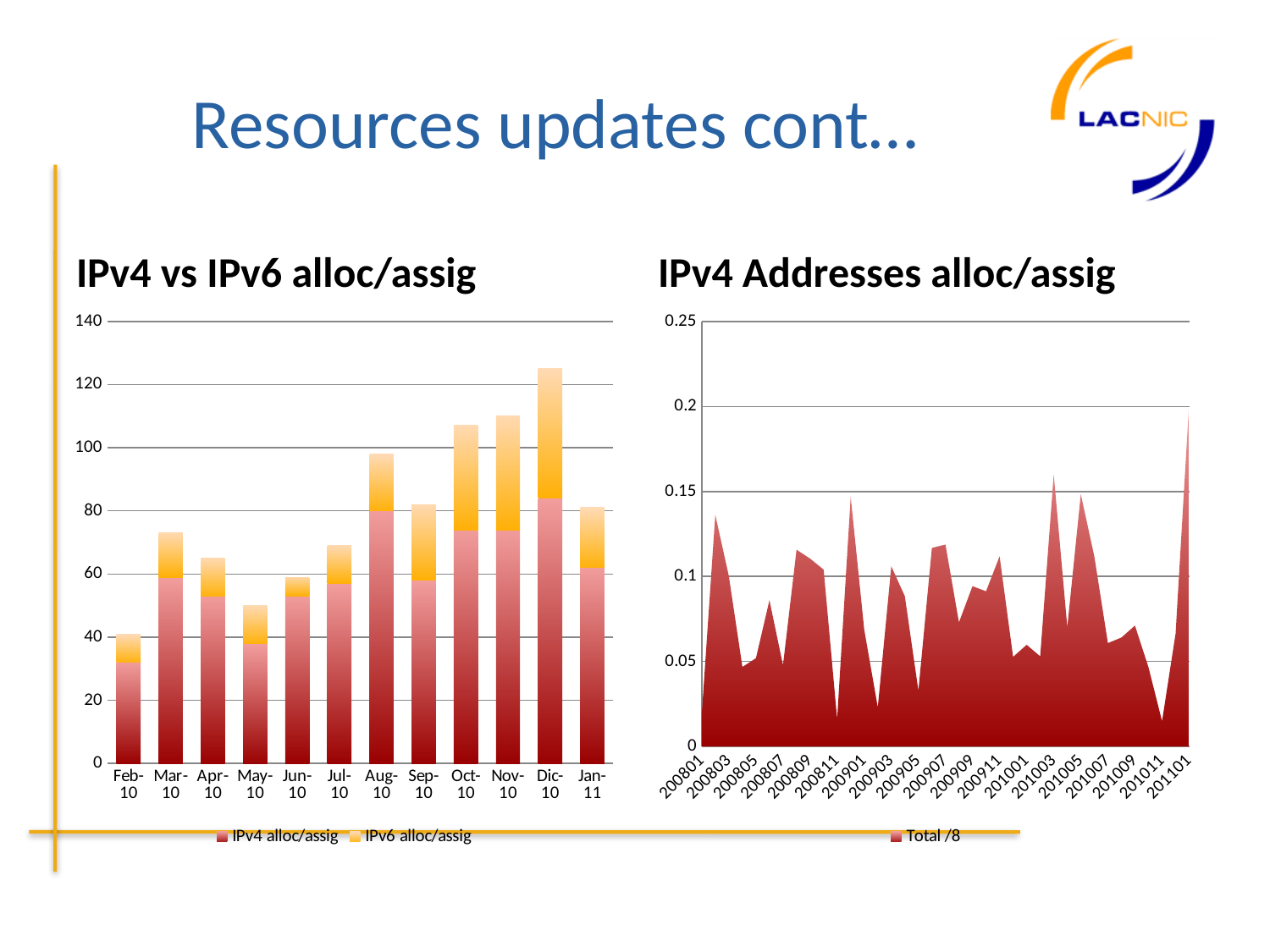
On the chart titled "IPv4 Addresses alloc/assig", what is the name of the series in the legend? Total /8 On the chart titled "IPv4 vs IPv6 alloc/assig", which month has the lowest total bar? Feb-10 On the chart titled "IPv4 Addresses alloc/assig", is the value at 201101 greater or less than 0.15? greater On the chart titled "IPv4 vs IPv6 alloc/assig", which month has the highest total bar? Dic-10 On the chart titled "IPv4 Addresses alloc/assig", what kind of chart is it? Area chart On the chart titled "IPv4 vs IPv6 alloc/assig", how many months are shown on the x axis? 12 On the chart titled "IPv4 vs IPv6 alloc/assig", what are the two legend entries? IPv4 alloc/assig and IPv6 alloc/assig On the chart titled "IPv4 vs IPv6 alloc/assig", what kind of chart is it? Stacked bar chart On the chart titled "IPv4 vs IPv6 alloc/assig", which has the larger total bar, Mar-10 or Apr-10? Mar-10 On the chart titled "IPv4 vs IPv6 alloc/assig", how many series does the legend list? 2 On the chart titled "IPv4 vs IPv6 alloc/assig", is the total bar for Dic-10 greater or less than 120? greater On the chart titled "IPv4 vs IPv6 alloc/assig", is the total bar for Feb-10 greater or less than 60? less